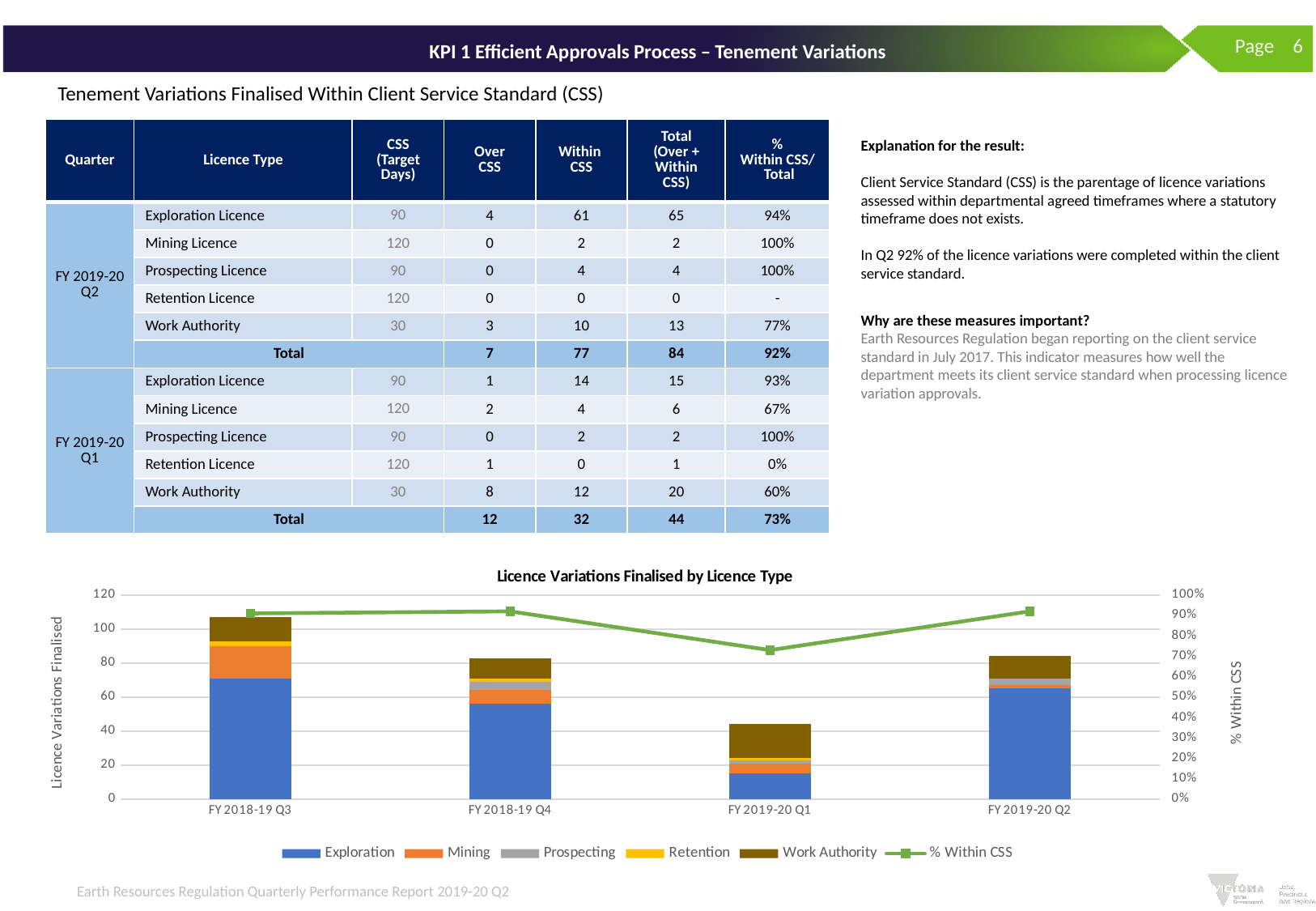
In the 'Licence Variations Finalised by Licence Type' chart, is the % Within CSS line value for FY 2019-20 Q1 greater or less than 80%? less In the 'Licence Variations Finalised by Licence Type' chart, which quarter has the tallest stacked bar? FY 2018-19 Q3 In the 'Licence Variations Finalised by Licence Type' chart, which stacked bar is taller: FY 2018-19 Q3 or FY 2019-20 Q2? FY 2018-19 Q3 How many quarters are shown on the x axis of the 'Licence Variations Finalised by Licence Type' chart? 4 In the 'Licence Variations Finalised by Licence Type' chart, which quarter has the shortest stacked bar? FY 2019-20 Q1 What kind of chart is 'Licence Variations Finalised by Licence Type'? A stacked bar chart with a line In the 'Licence Variations Finalised by Licence Type' chart, is the total stacked bar for FY 2019-20 Q1 greater or less than 60? less In the 'Licence Variations Finalised by Licence Type' chart, which colour represents the Exploration series? Blue What is the total of the stacked bar for FY 2019-20 Q2 in the 'Licence Variations Finalised by Licence Type' chart, as given in the table's Total row? 84 How many series does the legend of the 'Licence Variations Finalised by Licence Type' chart list? 6 In the 'Licence Variations Finalised by Licence Type' chart, does the % Within CSS line rise or fall from FY 2018-19 Q4 to FY 2019-20 Q1? fall In the 'Licence Variations Finalised by Licence Type' chart, is the total stacked bar for FY 2018-19 Q3 greater or less than 100? greater